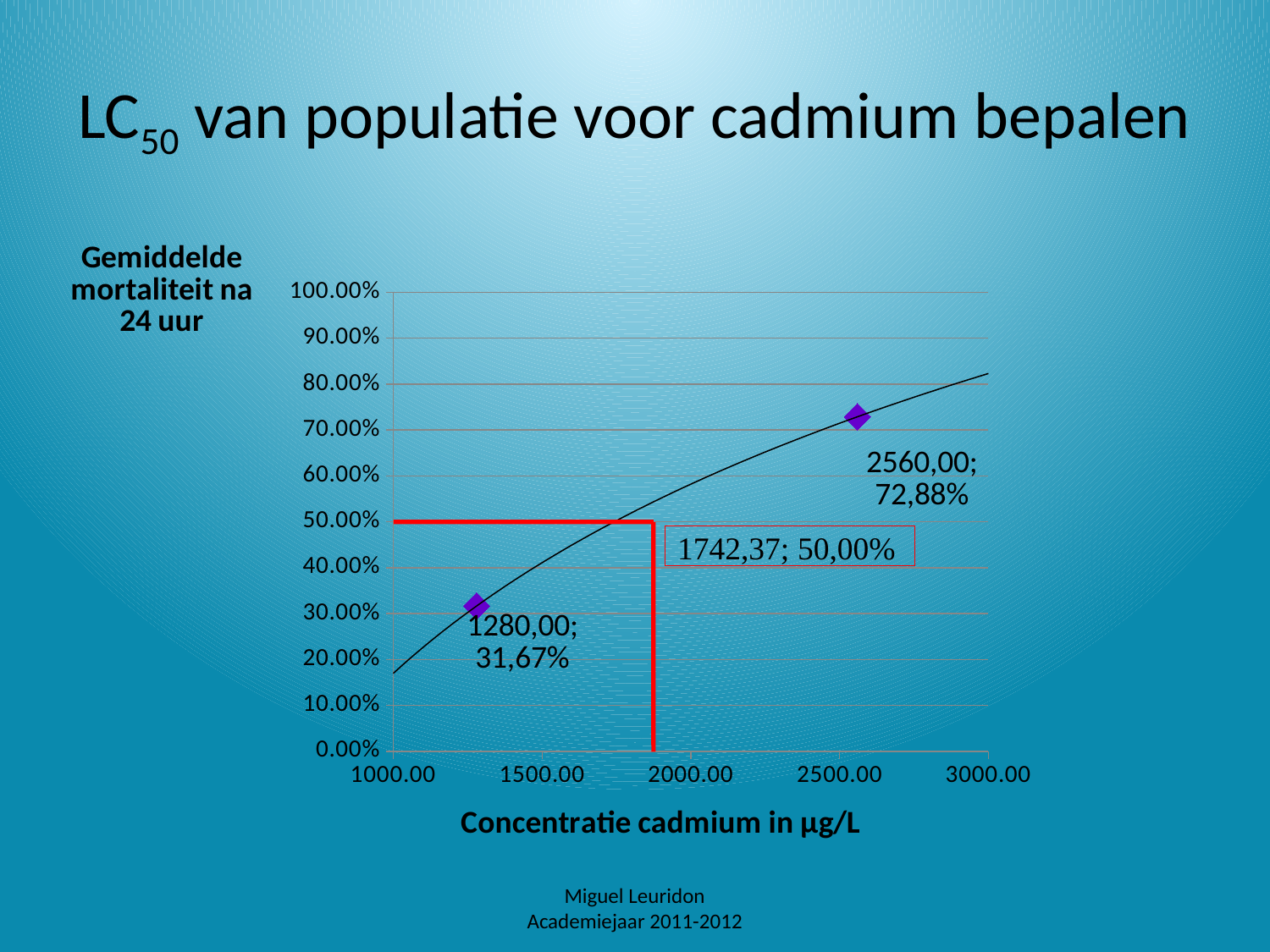
What is the label of the x axis of the chart? Concentratie cadmium in µg/L Is the mortality for the data point at 2560,00 µg/L greater or less than 70.00%? greater What is the label of the y axis of the chart? Gemiddelde mortaliteit na 24 uur Is the mortality for the data point at 1280,00 µg/L greater or less than 40.00%? less What is the mortality value shown for the data point at a cadmium concentration of 2560,00 µg/L? 72,88% Does the mortality rise or fall as the cadmium concentration increases along the x axis? rise At which cadmium concentration does the annotated box indicate a mortality of 50,00%? 1742,37 How many plotted data points (diamond markers) are shown on the chart? 2 Which plotted data point has the higher mortality, the one at 1280,00 or the one at 2560,00 µg/L? 2560,00 What is the difference in mortality between the data points at 2560,00 and 1280,00 µg/L? 41,21% What kind of chart is shown on the slide? scatter chart What is the mortality value shown for the data point at a cadmium concentration of 1280,00 µg/L? 31,67%